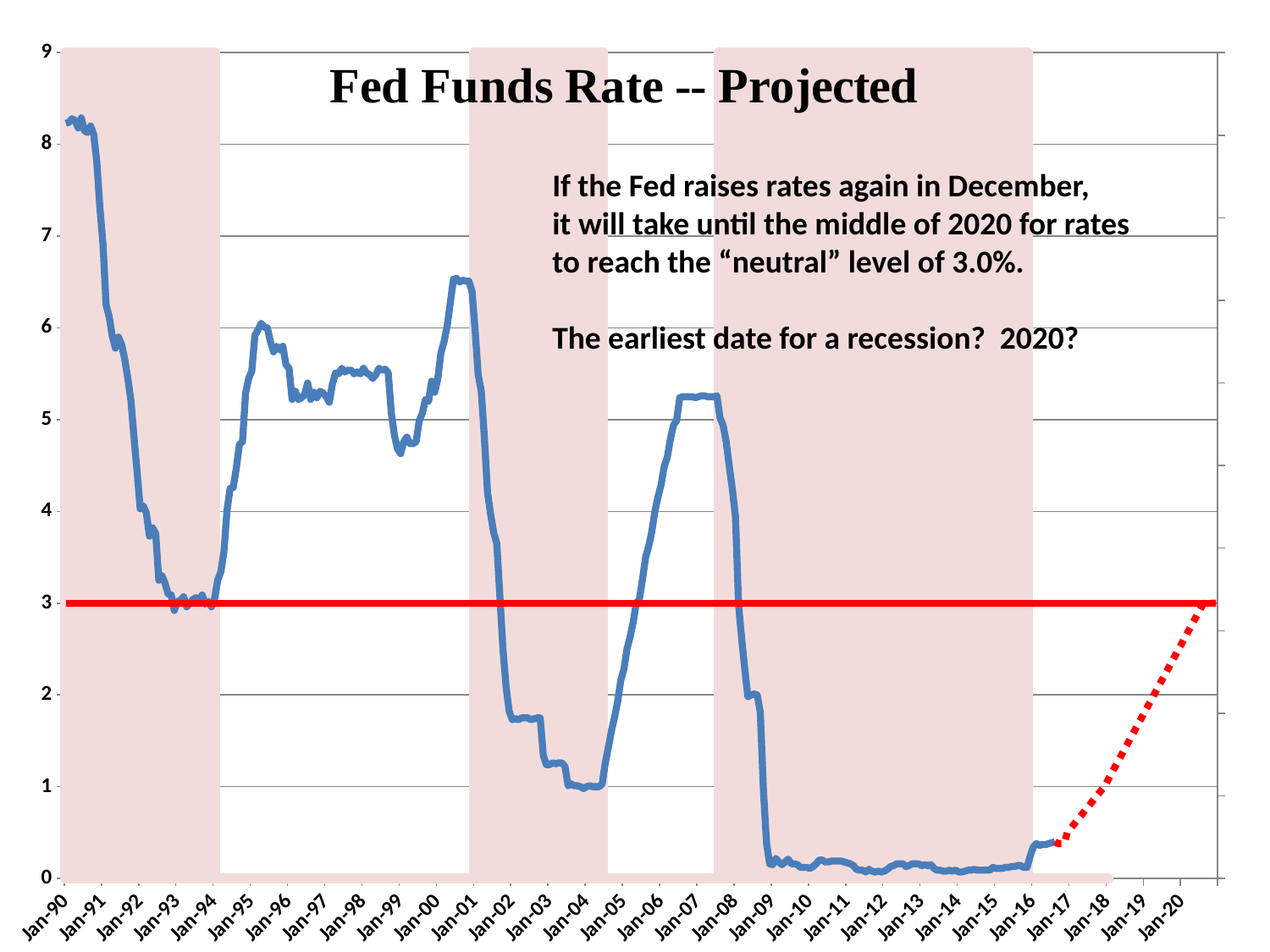
At what level on the y axis is the solid horizontal red line drawn? 3 What is the title of the chart? Fed Funds Rate -- Projected What kind of chart is shown on the slide? line chart Which is larger, the value at Jan-90 or the value at Jan-93? Jan-90 Is the value at Jan-12 greater or less than 1? less Does the Fed Funds Rate rise or fall between Jan-04 and Jan-07? rise Does the Fed Funds Rate rise or fall between Jan-01 and Jan-04? fall Is the value at Jan-90 greater or less than 8? greater Is the value at Jan-07 greater or less than 5? greater